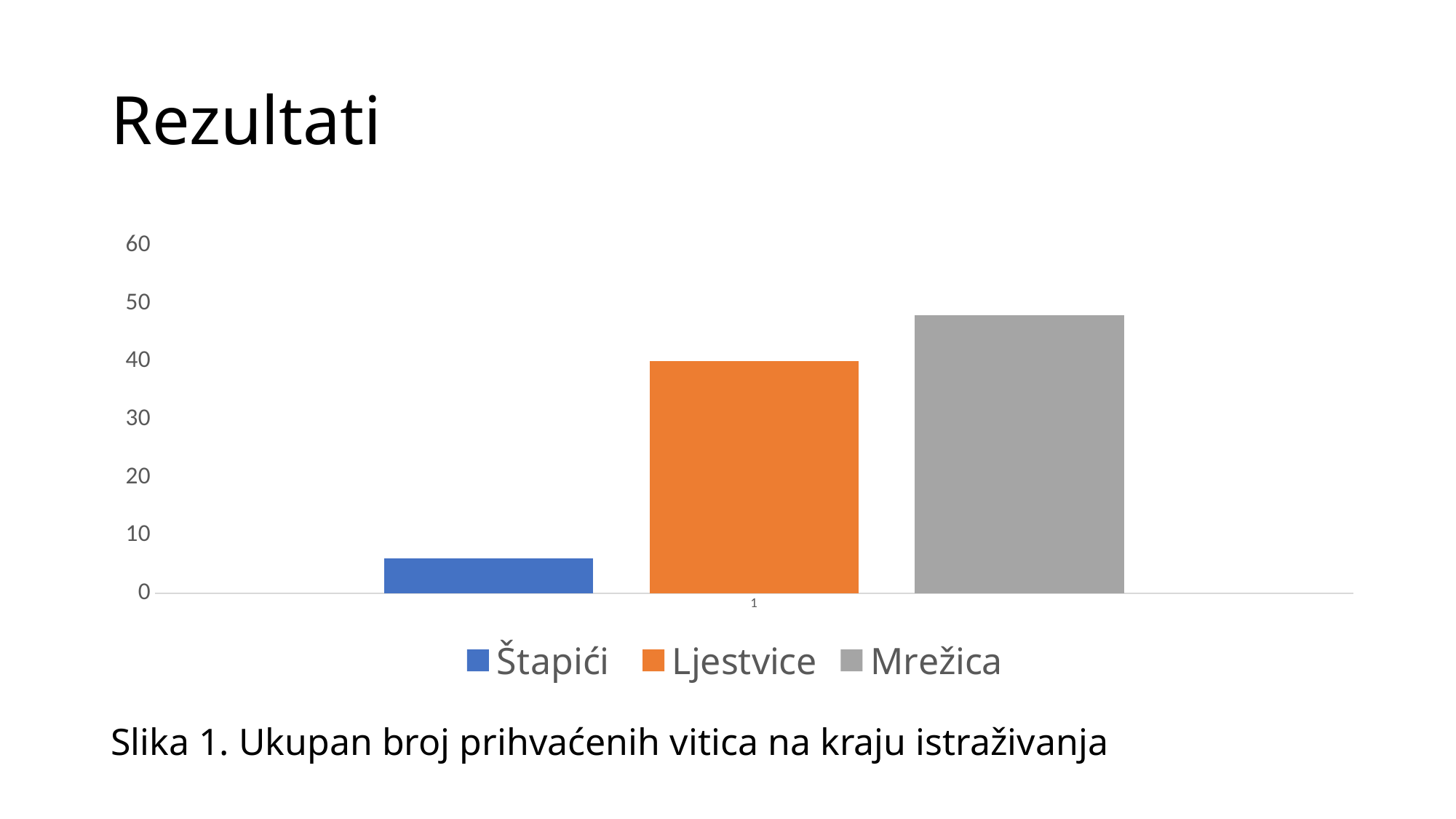
Which is larger, the value for Mrežica or the value for Ljestvice? Mrežica Is the value for Ljestvice greater or less than 30? greater Which series has the lowest bar? Štapići What colour is the bar for Ljestvice? orange Which is larger, the value for Štapići or the value for Ljestvice? Ljestvice Is the value for Mrežica greater or less than 50? less What is the caption printed below the chart? Slika 1. Ukupan broj prihvaćenih vitica na kraju istraživanja Which series has the highest bar? Mrežica How many series does the legend list? 3 Is the value for Štapići greater or less than 10? less What kind of chart is shown on the slide? bar chart